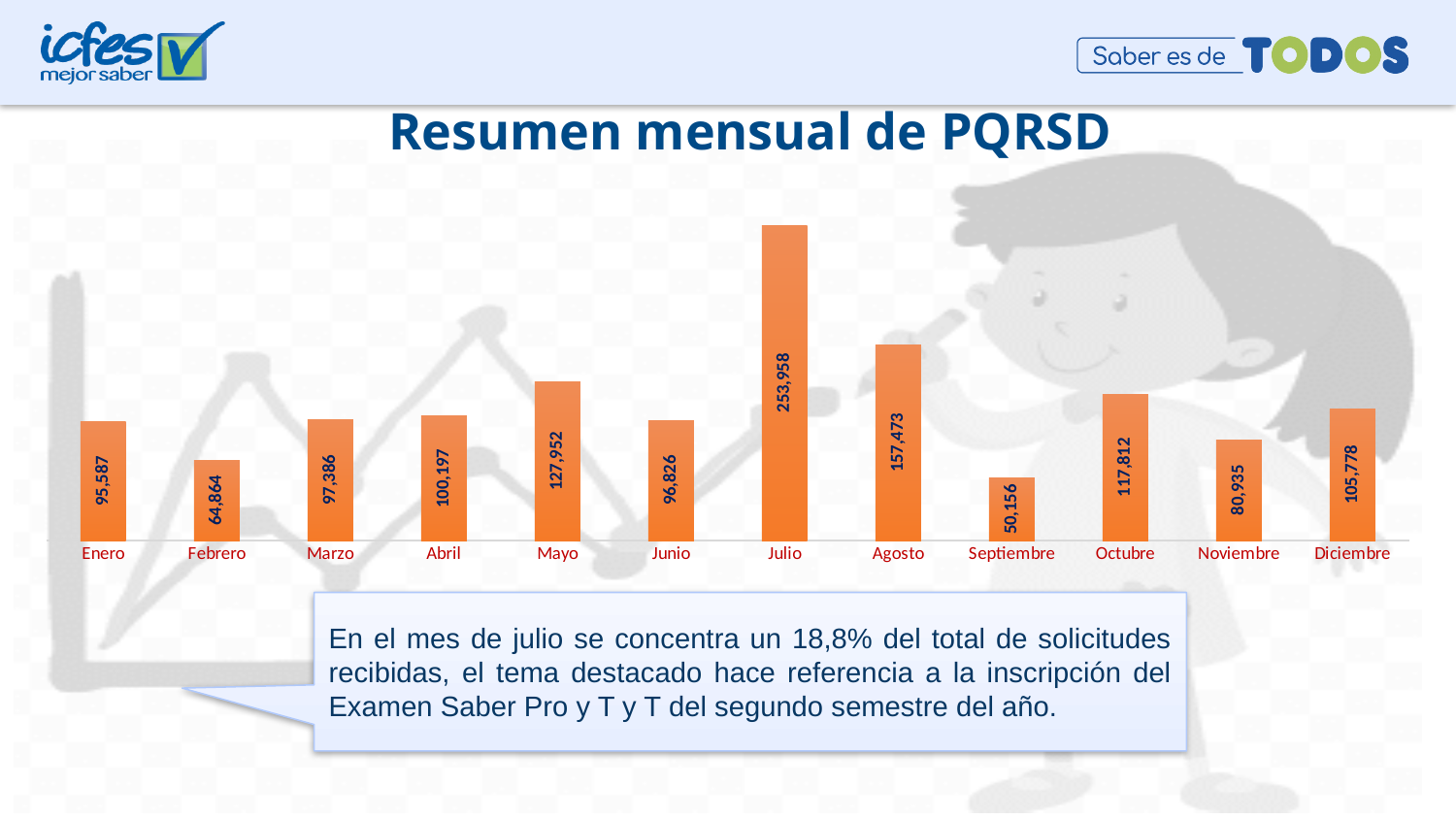
What is the value for Diciembre? 105,778 Which month has the highest value? Julio What is the difference between the values for Enero and Febrero? 30,723 How many months are shown on the x axis? 12 Which month has the lowest value? Septiembre What is the value for Septiembre? 50,156 What is the value for Mayo? 127,952 Which is larger, the value for Octubre or the value for Diciembre? Octubre What kind of chart is shown on the slide? Bar chart From Marzo to Mayo, do the values rise or fall? Rise What is the value for Julio? 253,958 What is the difference between the values for Julio and Agosto? 96,485